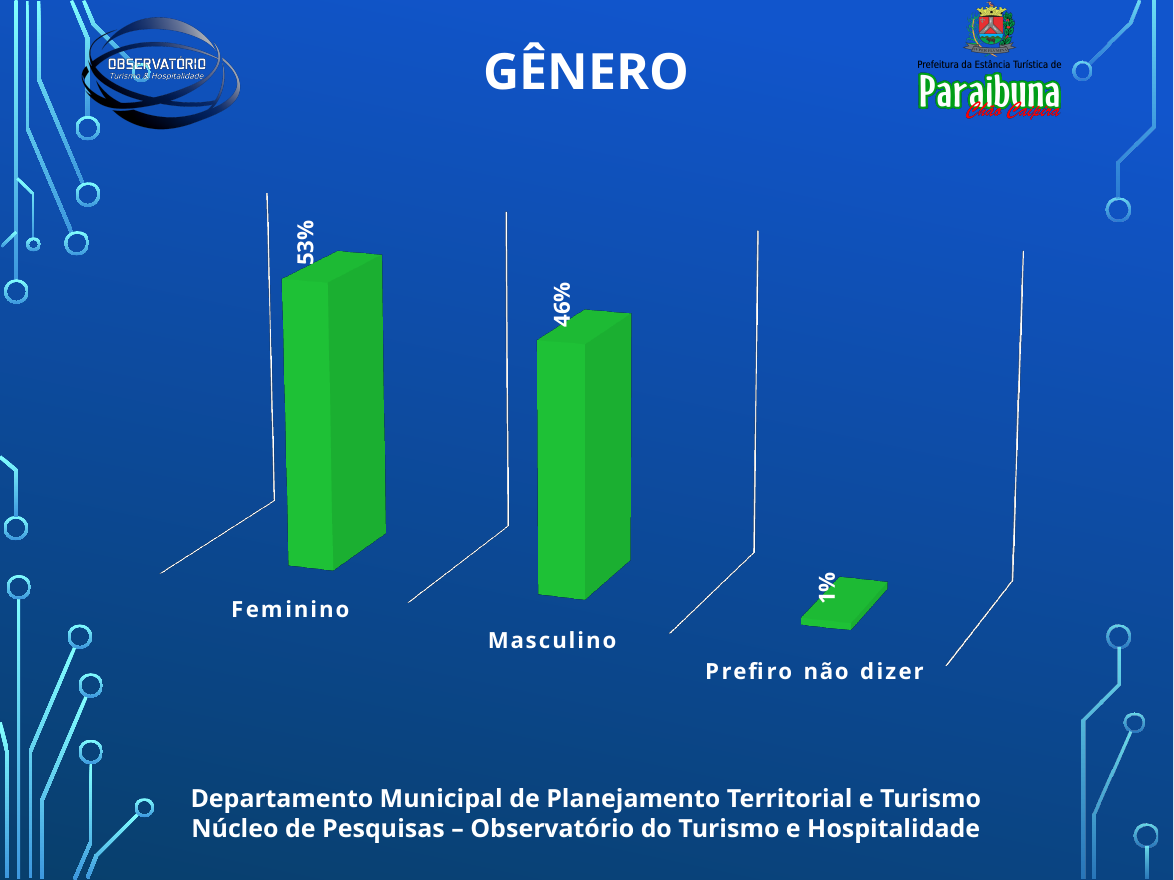
Which category has the lowest value? Prefiro não dizer What is the title of the chart? GÊNERO Do the values rise or fall from left to right across the categories? fall What is the value for Masculino? 46% What is the difference between the values for Feminino and Masculino? 7% What is the value for Prefiro não dizer? 1% What is the difference between the values for Masculino and Prefiro não dizer? 45% Which category has the highest value? Feminino How many categories are shown in the chart? 3 Which is larger, the value for Feminino or the value for Masculino? Feminino What kind of chart is shown on the slide? bar chart What is the value for Feminino? 53%